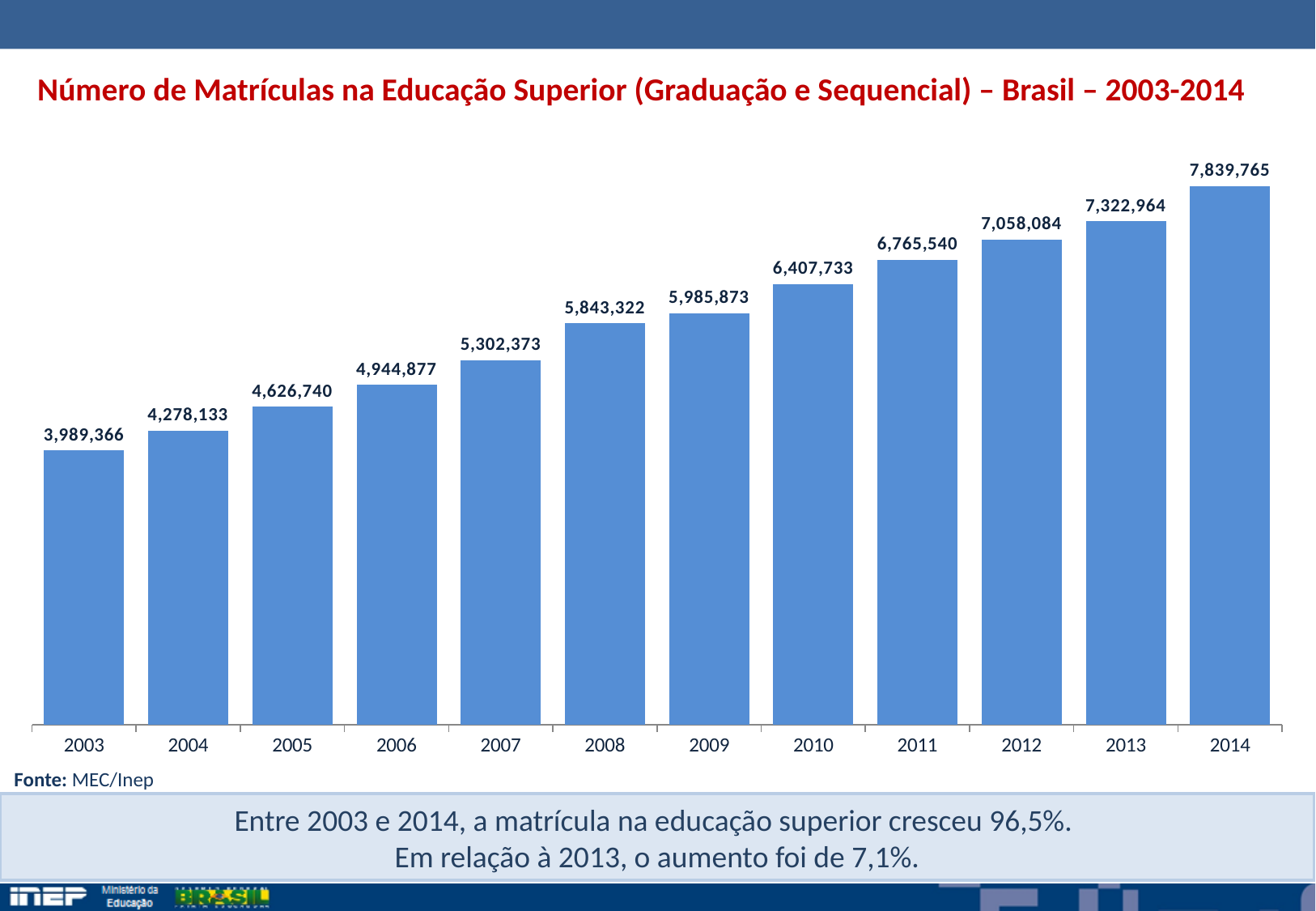
Which year has the highest number of enrolments? 2014 What kind of chart is shown on the slide? Bar chart What is the difference between the values for 2013 and 2012? 264,880 How many years are shown on the x axis? 12 What is the value for 2007? 5,302,373 Which year has the lowest number of enrolments? 2003 Do the values rise or fall from 2003 to 2014? Rise Which is larger, the value for 2008 or the value for 2006? 2008 What is the difference between the values for 2014 and 2003? 3,850,399 What value is shown for 2003? 3,989,366 What is the number of enrolments shown for 2010? 6,407,733 What source is cited below the chart? MEC/Inep